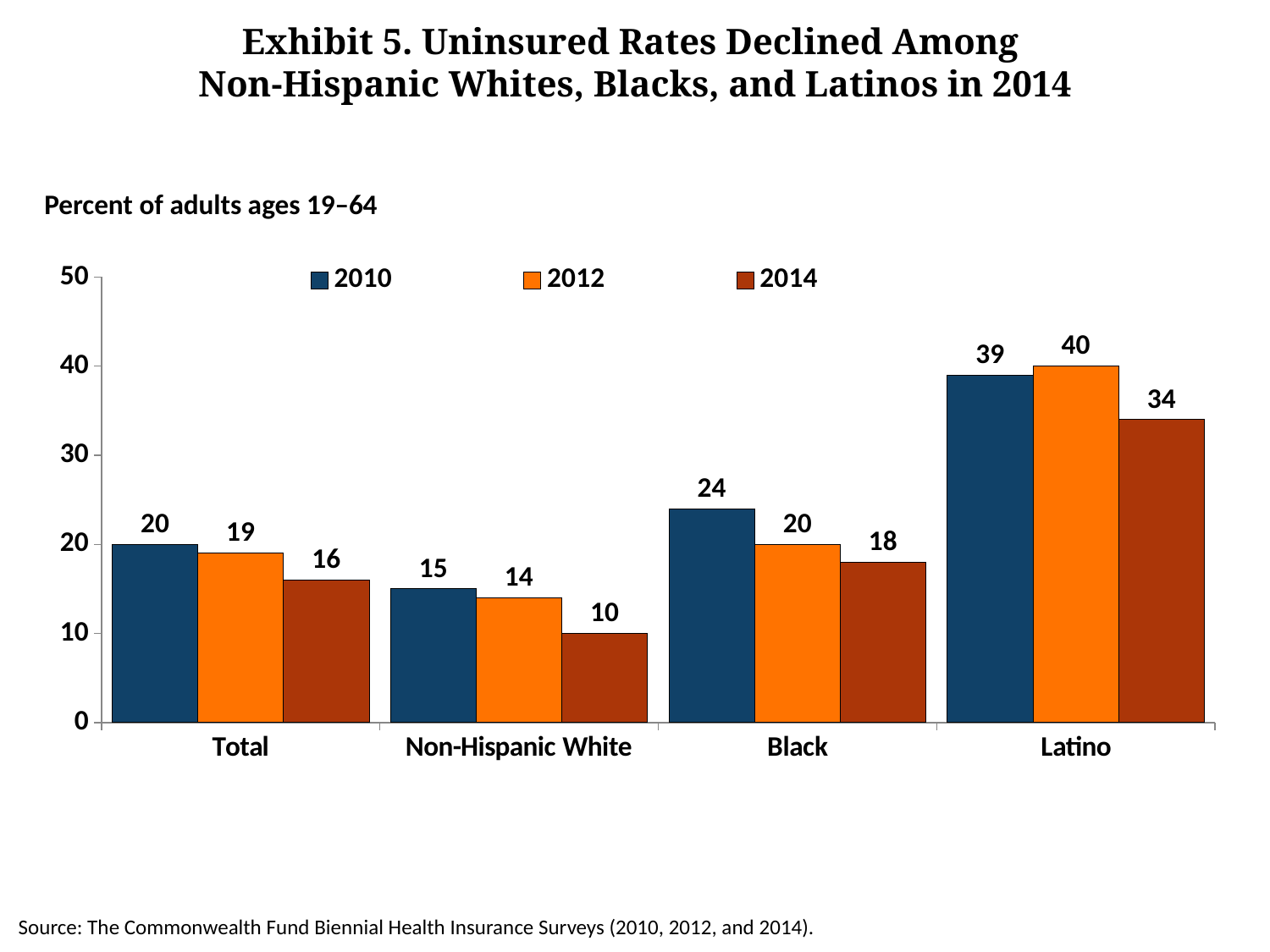
Is the 2014 value for Total greater or less than 20? less What is the 2014 uninsured rate for Latino adults? 34 What is the difference between the 2010 and 2014 values for Black adults? 6 Which category has the highest 2014 value? Latino How many series does the legend list? 3 What is the 2012 value for Non-Hispanic White adults? 14 Which is larger for Latino adults, the 2010 value or the 2012 value? 2012 Which year does the dark blue series represent? 2010 What kind of chart is shown on the slide? Bar chart How many categories are shown on the x axis? 4 What is the 2010 value for Black adults? 24 Which category has the lowest 2014 value? Non-Hispanic White